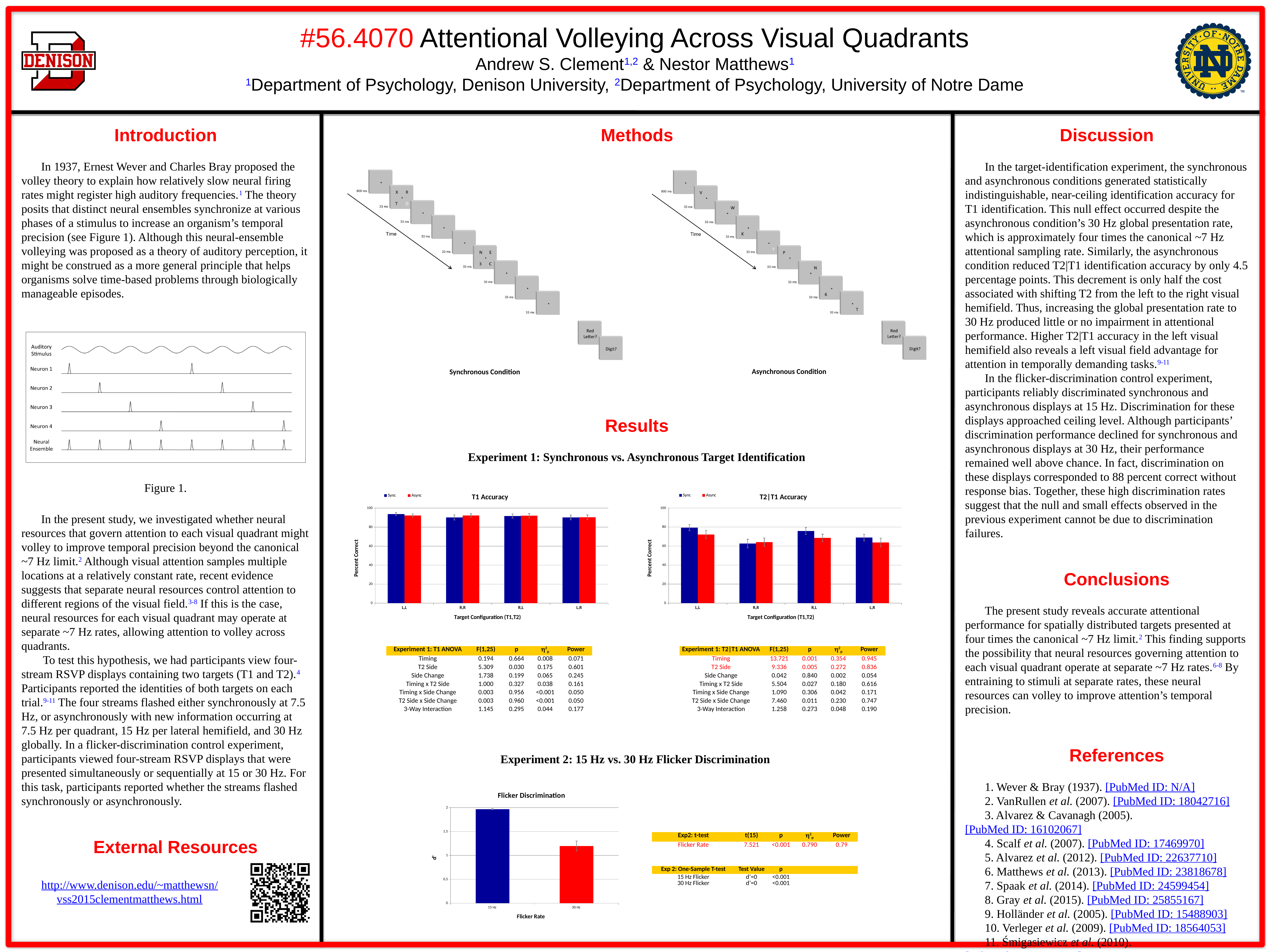
In the Flicker Discrimination chart, which flicker rate has the higher d' value? 15 Hz In the Flicker Discrimination chart, is the d' value for 15 Hz greater or less than 1.5? greater In the T1 Accuracy chart, is the Sync value for L,L greater or less than 80? greater How many series does the legend of the T1 Accuracy chart list? 2 How many target configuration categories are shown on the x axis of the T2|T1 Accuracy chart? 4 In the T2|T1 Accuracy chart, which target configuration has the highest Sync percent correct? L,L What is the y-axis label of the Flicker Discrimination chart? d' What kind of chart is the Flicker Discrimination chart? bar chart In the Flicker Discrimination chart, is the d' value for 30 Hz greater or less than 1.5? less In the T2|T1 Accuracy chart, which target configuration has the lowest Sync percent correct? R,R How many flicker rate categories are shown in the Flicker Discrimination chart? 2 In the T2|T1 Accuracy chart, is the Sync value for L,L larger or the Sync value for R,R? L,L